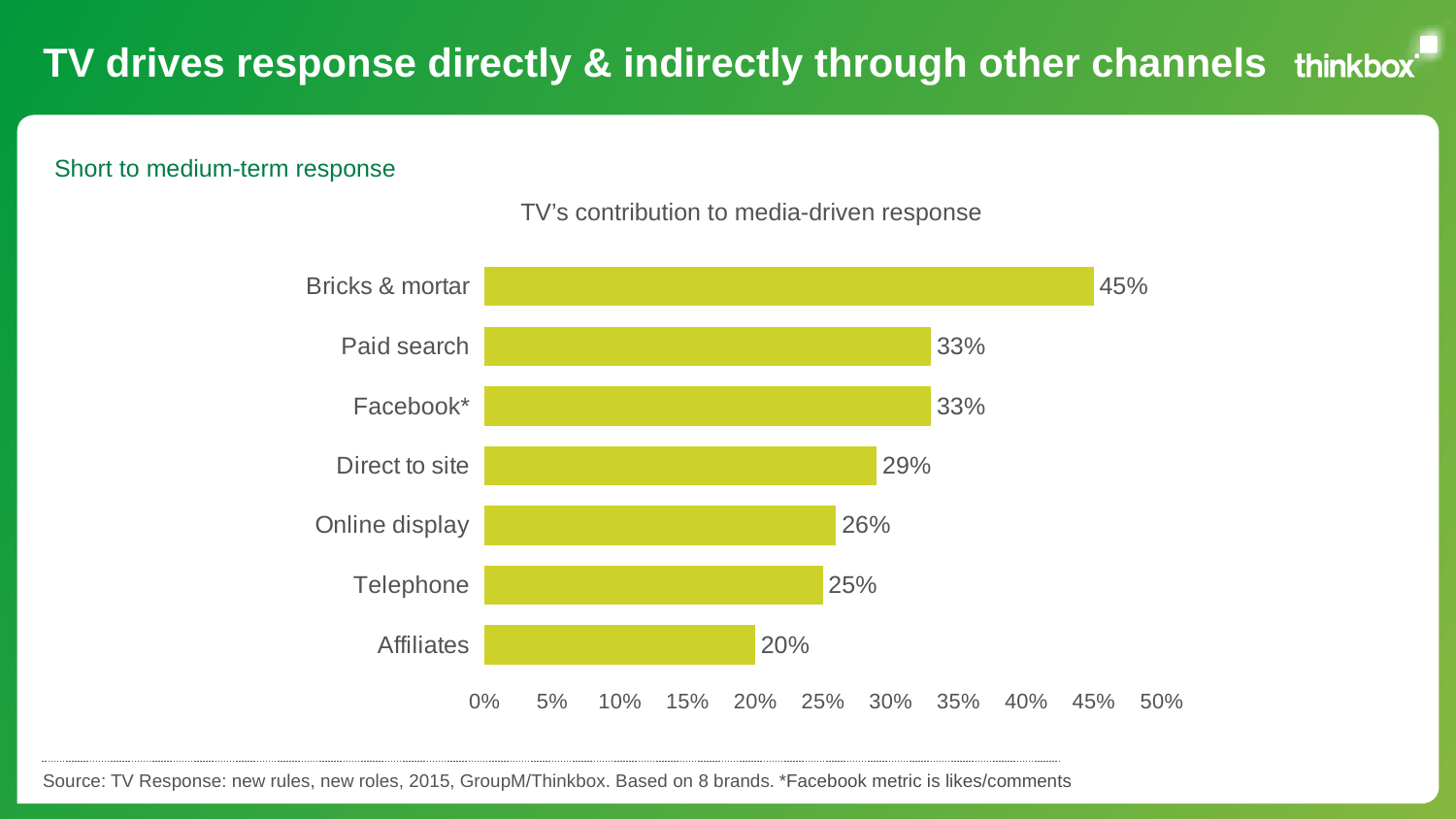
What is the title of the chart? TV's contribution to media-driven response Which category has the lowest value? Affiliates Which category has the highest value? Bricks & mortar What is the difference between the values for Paid search and Online display? 7% What is the value for Bricks & mortar? 45% Is the value for Online display greater or less than 30%? less What kind of chart is shown on the slide? bar chart How many categories are shown in the chart? 7 Which is larger, the value for Direct to site or the value for Telephone? Direct to site What is the value for Telephone? 25% What is the value for Direct to site? 29% What is the difference between the values for Bricks & mortar and Affiliates? 25%